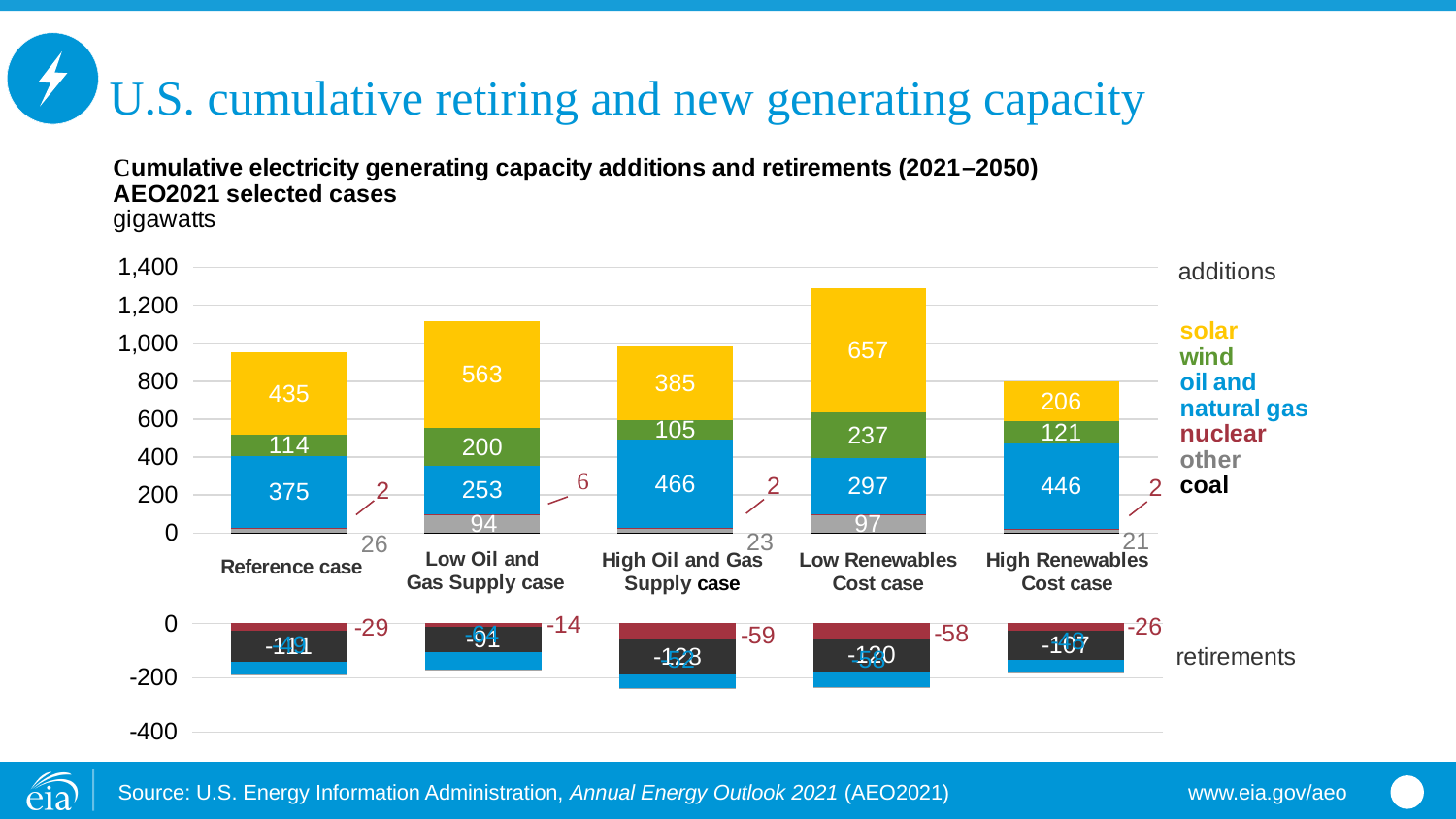
In the additions chart, is the total addition for the Low Renewables Cost case greater or less than 1,200? greater In the additions chart, what is the wind capacity addition for the Reference case? 114 In the additions chart, what is the solar capacity addition for the Low Renewables Cost case? 657 In the additions chart, how much larger is the solar addition in the Low Oil and Gas Supply case than in the Reference case? 128 In the retirements chart, what is the nuclear retirement value for the High Oil and Gas Supply case? -59 In the additions chart, which case has the larger wind addition: Low Renewables Cost case or High Renewables Cost case? Low Renewables Cost case In the additions chart, which case has the highest solar addition? Low Renewables Cost case What kind of chart is used to show the additions? Stacked bar chart How many series does the legend list? 6 In the additions chart, what is the oil and natural gas capacity addition for the High Oil and Gas Supply case? 466 In the additions chart, which case has the lowest solar addition? High Renewables Cost case How many cases are shown along the x axis of the additions chart? 5